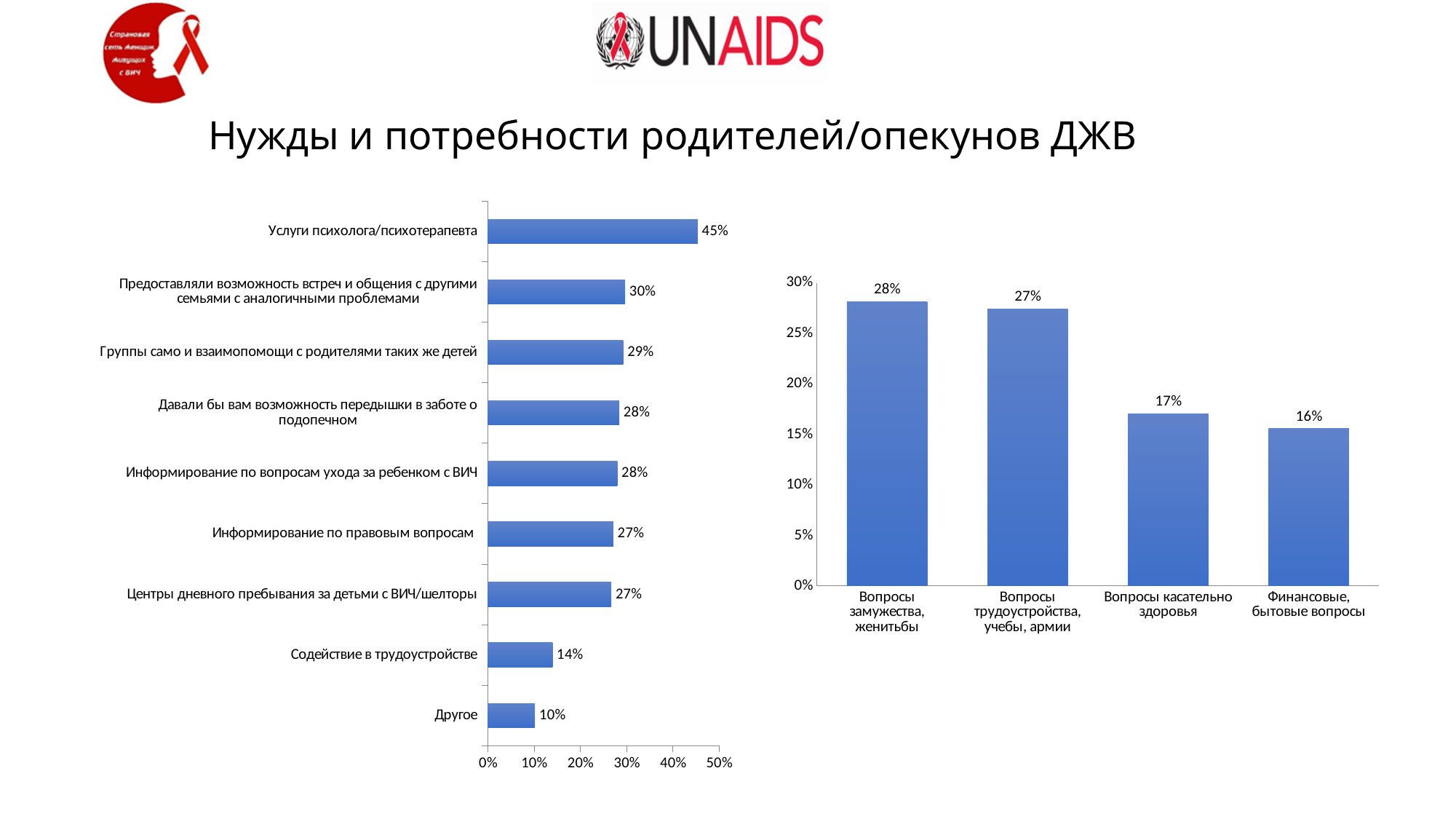
In the left chart, which category has the highest value? Услуги психолога/психотерапевта In the left chart, what is the value for Содействие в трудоустройстве? 14% In the left chart, how many categories are shown? 9 In the left chart, what kind of chart is it? Bar chart In the right chart, what is the difference between Вопросы замужества, женитьбы and Вопросы касательно здоровья? 11% In the left chart, what is the difference between Услуги психолога/психотерапевта and Другое? 35% In the right chart, how many categories are shown? 4 In the right chart, which category has the lowest value? Финансовые, бытовые вопросы In the right chart, what is the value for Вопросы касательно здоровья? 17% In the left chart, what is the value for Услуги психолога/психотерапевта? 45% In the left chart, which category has the lowest value? Другое In the right chart, which is larger: Вопросы замужества, женитьбы or Финансовые, бытовые вопросы? Вопросы замужества, женитьбы